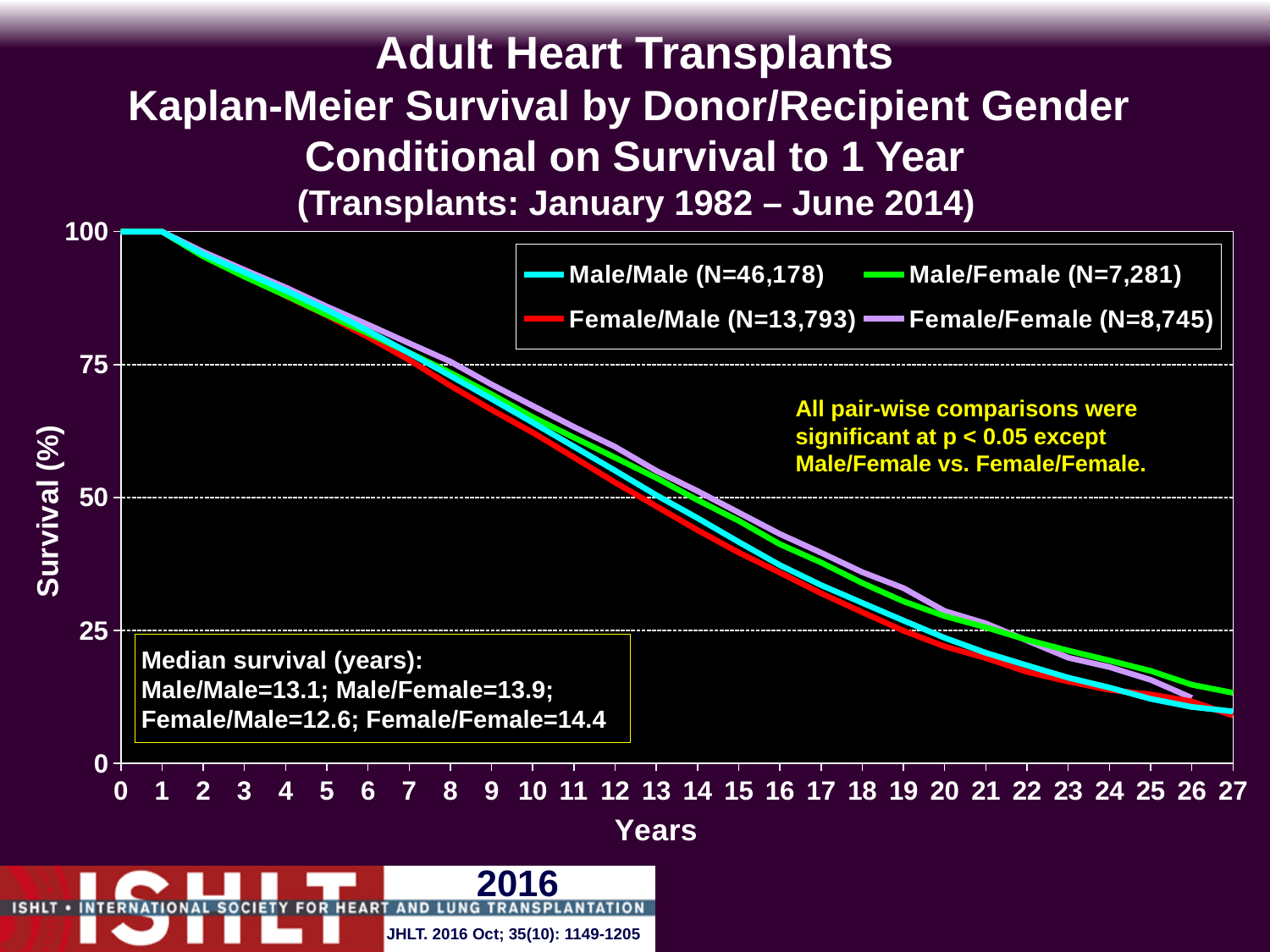
What is the median survival in years for Male/Male? 13.1 Which has the larger median survival, Male/Female or Male/Male? Male/Female What colour is the Female/Male line in the legend? red Is the survival for Female/Male at 25 years greater or less than 25? less What kind of chart is shown on the slide? line chart How many series does the legend list? 4 What is the median survival in years for Female/Female? 14.4 What is the difference in median survival (years) between Female/Female and Female/Male? 1.8 Is the survival for Male/Male at 10 years greater or less than 50? greater Which donor/recipient gender group has the lowest median survival? Female/Male Which donor/recipient gender group has the highest median survival? Female/Female Do the survival curves rise or fall as years increase? fall